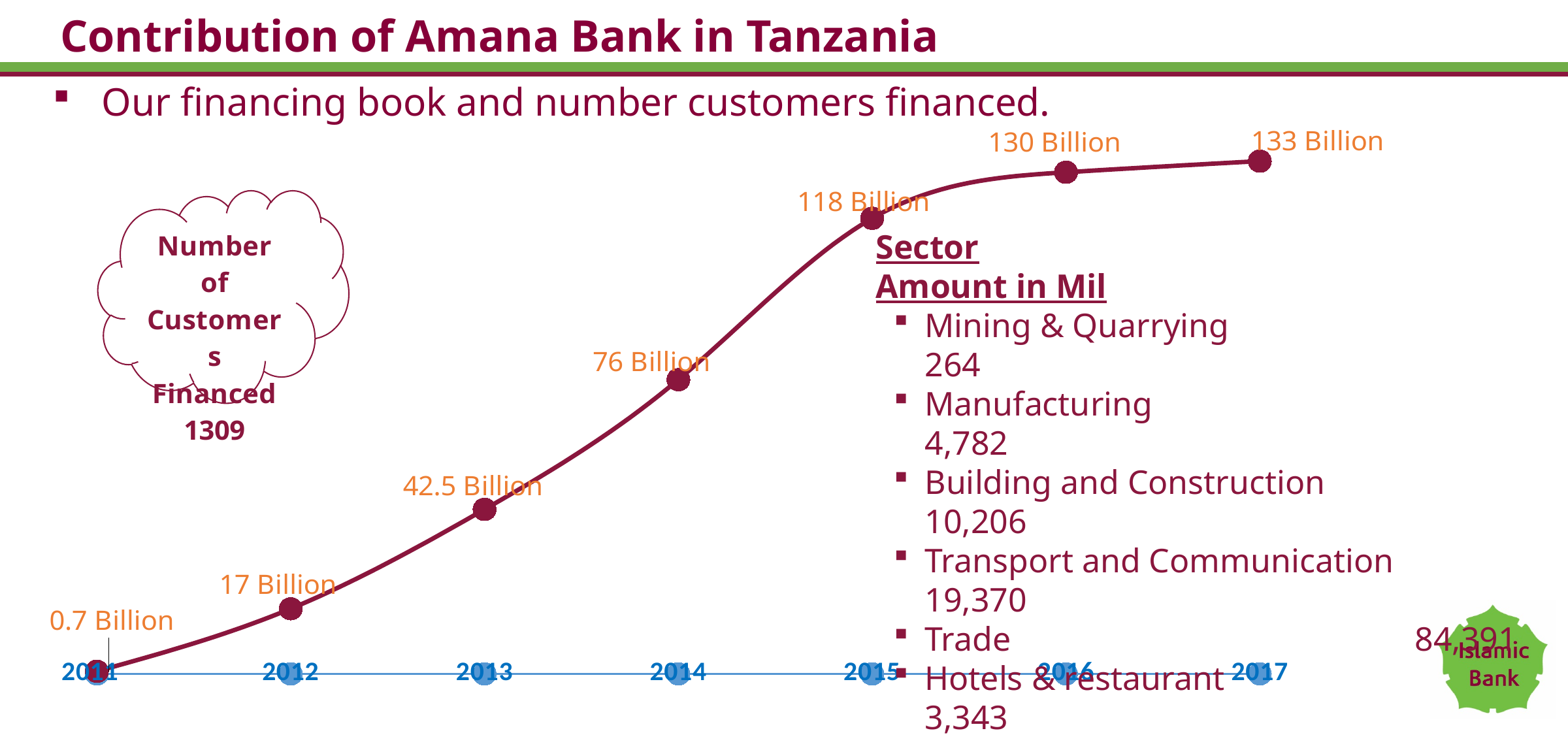
Do the financing book values rise or fall from 2011 to 2017? rise What is the financing book value for 2011? 0.7 Billion What is the financing book value for 2016? 130 Billion What is the difference between the financing book values for 2014 and 2013? 33.5 Billion Which is larger, the financing book value for 2014 or for 2015? 2015 Which year has the lowest financing book value? 2011 What is the financing book value for 2013? 42.5 Billion What is the difference between the financing book values for 2017 and 2016? 3 Billion How many years are plotted on the x axis of the chart? 7 What kind of chart is shown on the slide? line chart Which year has the highest financing book value? 2017 What is the first year shown on the x axis of the chart? 2011